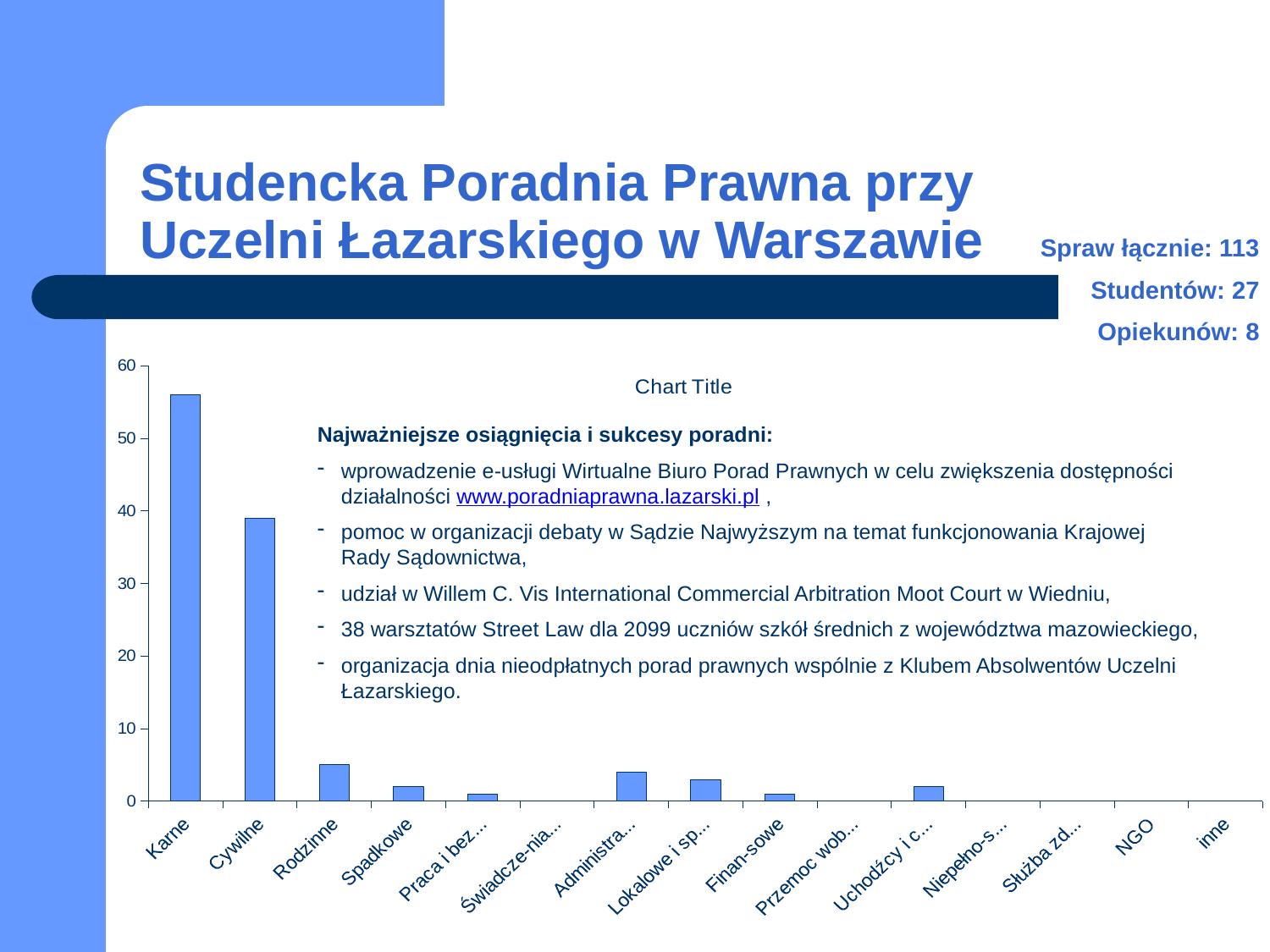
What kind of chart is shown on the slide? bar chart Which is larger, the value for Rodzinne or the value for Spadkowe? Rodzinne Is the value for Rodzinne greater or less than 10? less How many categories are shown on the x axis of the chart? 15 What is the title shown on the chart? Chart Title Which is larger, the value for Karne or the value for Cywilne? Karne Is the value for Karne greater or less than 50? greater What is the highest value shown on the vertical axis of the chart? 60 Which is larger, the value for Cywilne or the value for Lokalowe i sp...? Cywilne Is the value for Administra... greater or less than 10? less Which category has the highest bar in the chart? Karne